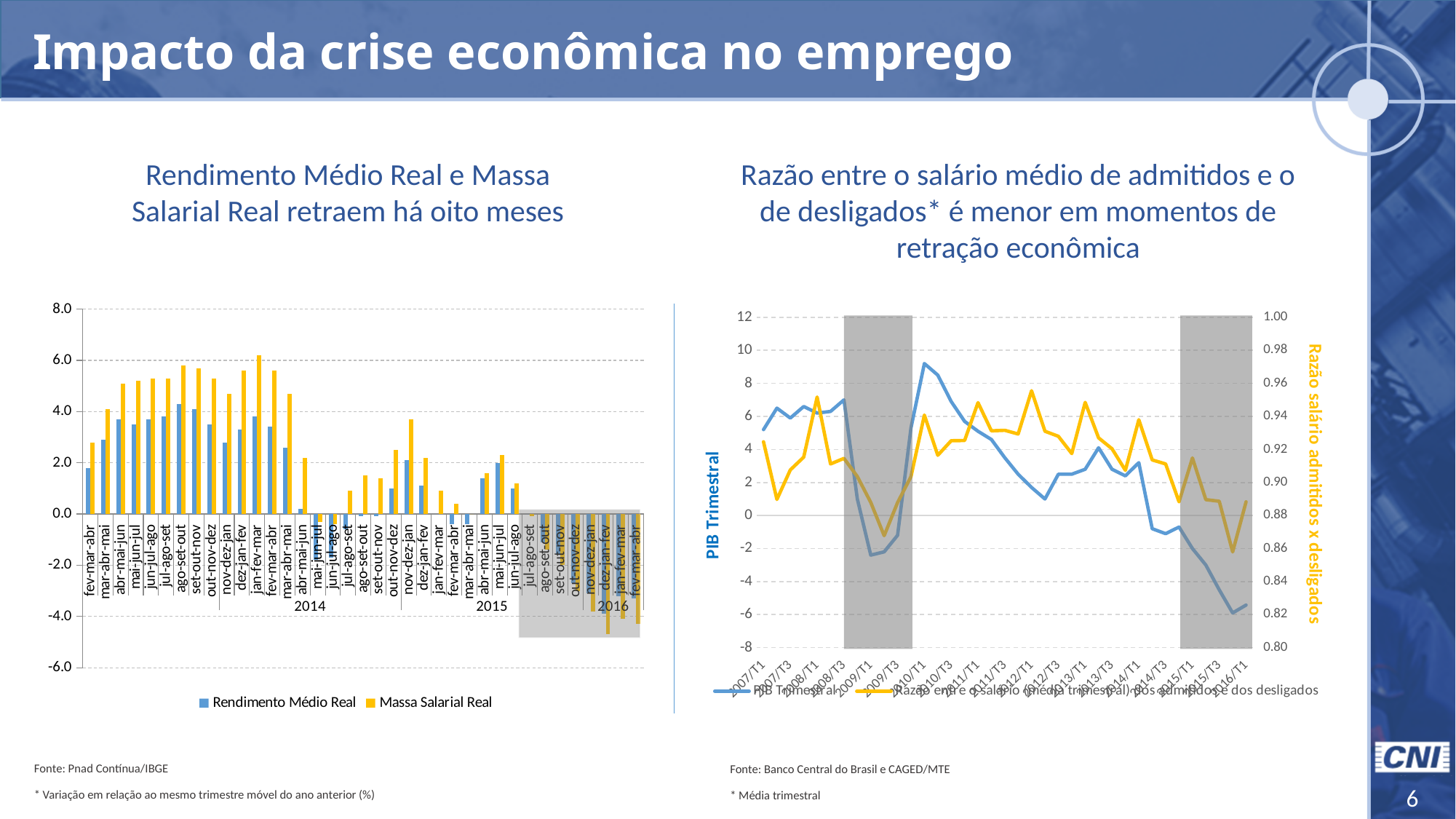
In the left chart, for the first period fev-mar-abr, which series has the larger value, Rendimento Médio Real or Massa Salarial Real? Massa Salarial Real What kind of chart is the left chart, 'Rendimento Médio Real e Massa Salarial Real retraem há oito meses'? bar chart In the left chart, are the bars for the 2016 periods at the right end positive or negative? negative In the right chart, is the peak value of PIB Trimestral around 2010/T1 greater or less than 8? greater In the right chart, is the highest value of the ratio series (right axis) greater or less than 0.94? greater What kind of chart is the right chart, 'Razão entre o salário médio de admitidos e o de desligados'? line chart How many series does the legend of the left chart list? 2 What are the two series named in the legend of the left chart? Rendimento Médio Real and Massa Salarial Real In the right chart, is the PIB Trimestral value at 2009/T1 greater or less than 0? less In the right chart, does PIB Trimestral rise or fall from 2014/T1 to 2015/T3? fall